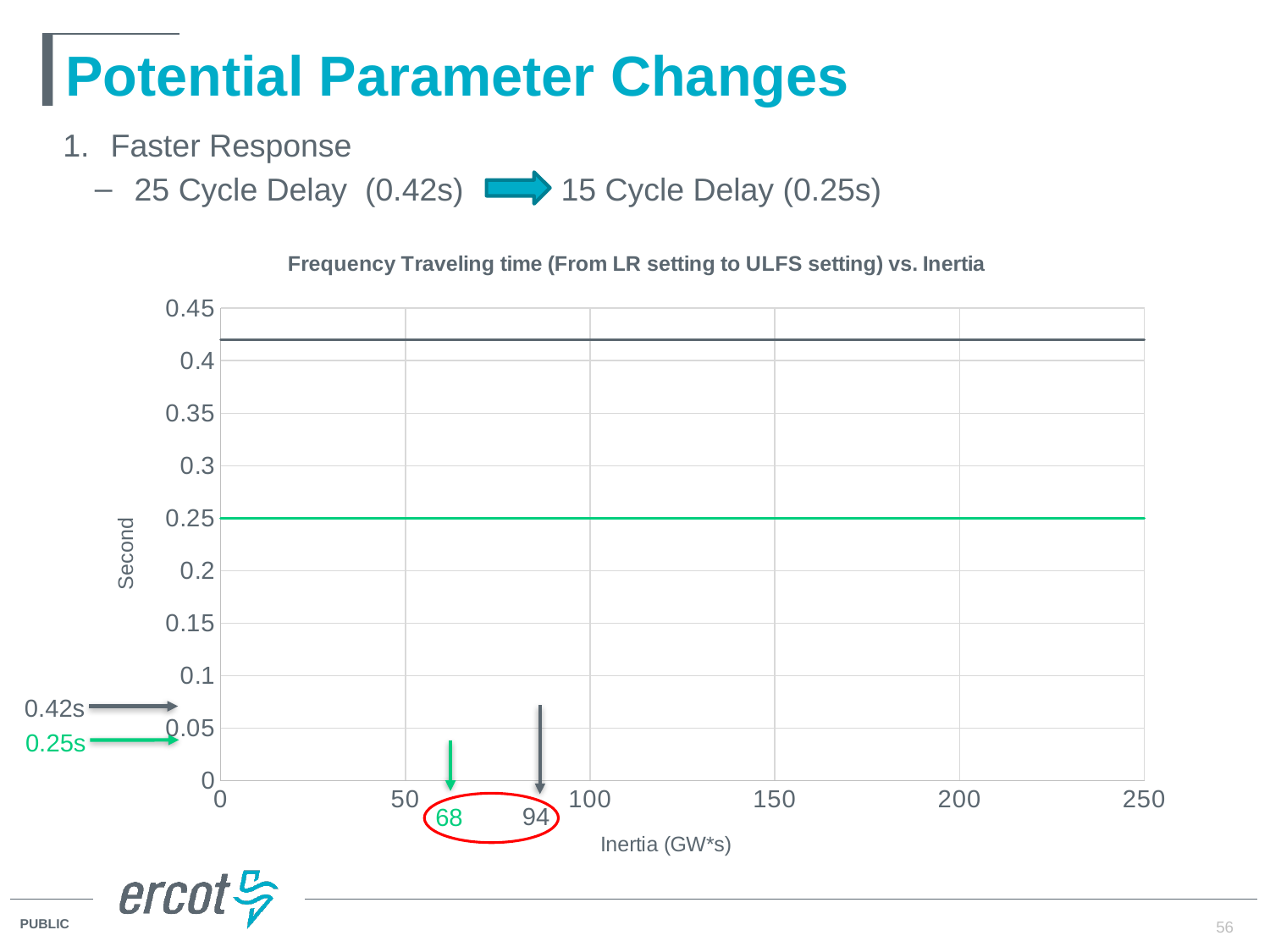
Which line is higher on the chart, the 0.42s line or the 0.25s line? 0.42s line Is the value of the green line greater or less than 0.3? less How many lines are plotted on the chart? 2 What is the label of the x axis of the chart? Inertia (GW*s) What kind of chart is shown on the slide? line chart What is the difference between the two inertia values circled in red below the x axis (94 and 68)? 26 What is the title of the chart? Frequency Traveling time (From LR setting to ULFS setting) vs. Inertia What value in seconds does the dark gray line represent? 0.42s What inertia value is marked by the green arrow below the x axis? 68 Do the plotted lines rise, fall, or stay flat as inertia increases along the x axis? stay flat Is the value of the dark gray line greater or less than 0.4? greater What value in seconds does the green line represent? 0.25s